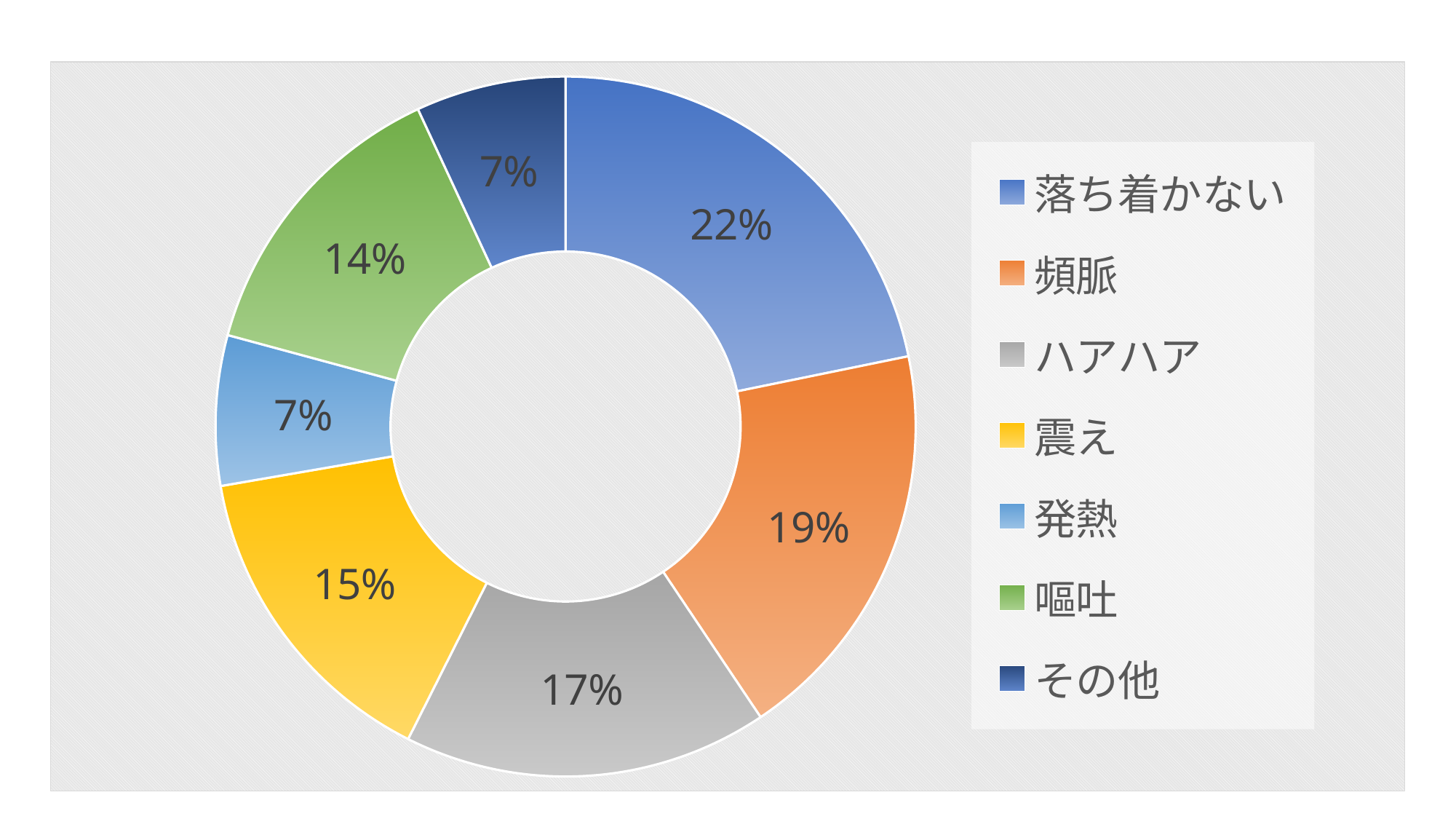
What percentage is shown for ハアハア? 17% What percentage is shown for 落ち着かない? 22% What percentage is shown for 震え? 15% Which has the larger share, 震え or 嘔吐? 震え What percentage is shown for 嘔吐? 14% What percentage is shown for 頻脈? 19% Which category has the largest share of the chart? 落ち着かない What kind of chart is shown on the slide? Doughnut chart What is the difference in percentage points between 落ち着かない and 頻脈? 3 percentage points Which legend entry is shown in orange? 頻脈 How many categories does the chart show? 7 What percentage is shown for 発熱? 7%